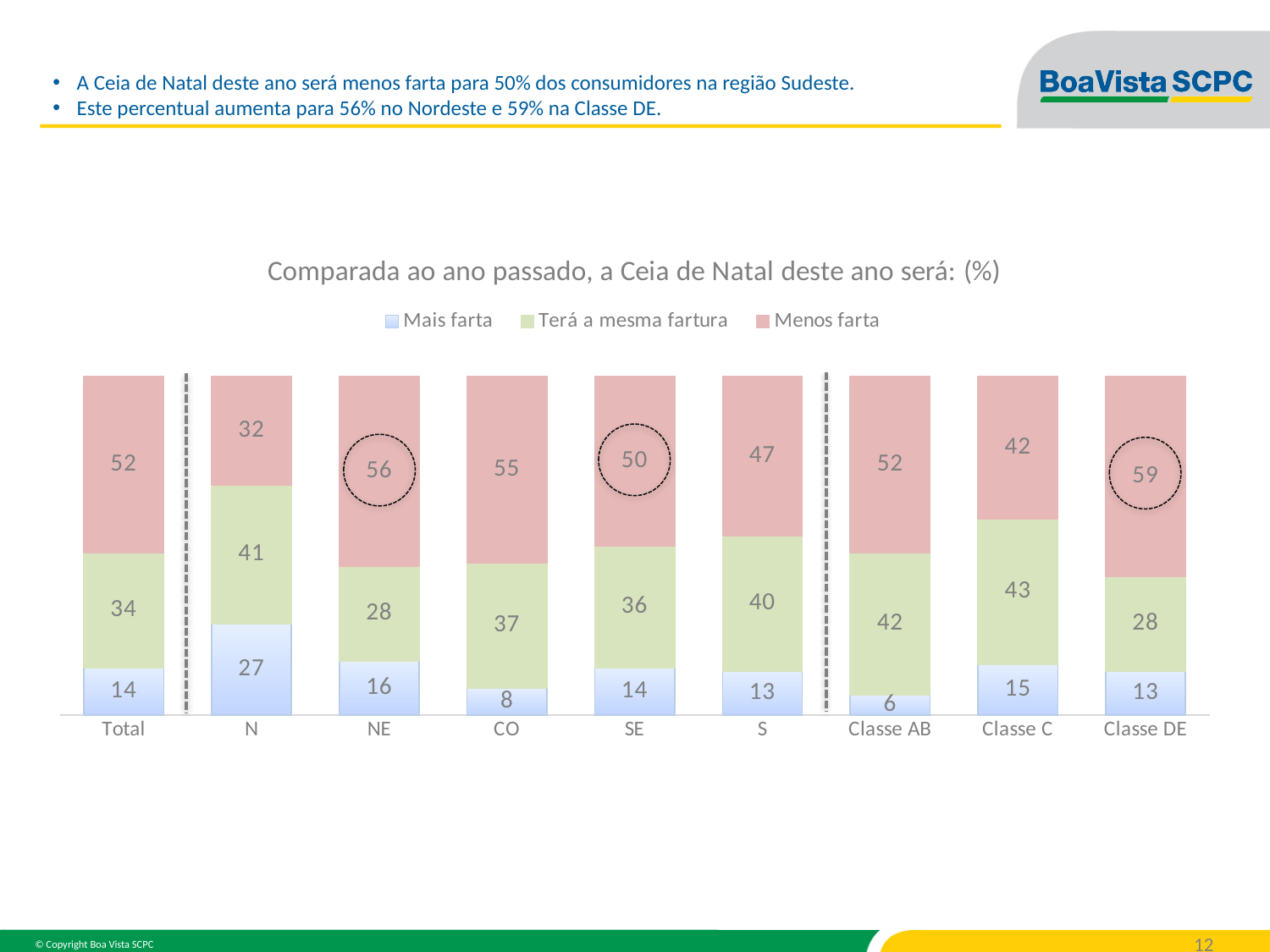
What is the value of "Mais farta" for N? 27 Which is larger: the "Terá a mesma fartura" value for Classe C or for Classe DE? Classe C How many series does the legend list? 3 What kind of chart is shown on the slide? Stacked bar chart What is the value of "Mais farta" for Classe AB? 6 What is the value of "Terá a mesma fartura" for S? 40 Which category has the lowest value for "Mais farta"? Classe AB Which category has the highest value for "Menos farta"? Classe DE How many categories are shown on the x axis? 9 What is the total of the stacked bar for CO? 100 What is the difference between the "Menos farta" values for NE and N? 24 What is the value of "Menos farta" for Classe DE? 59